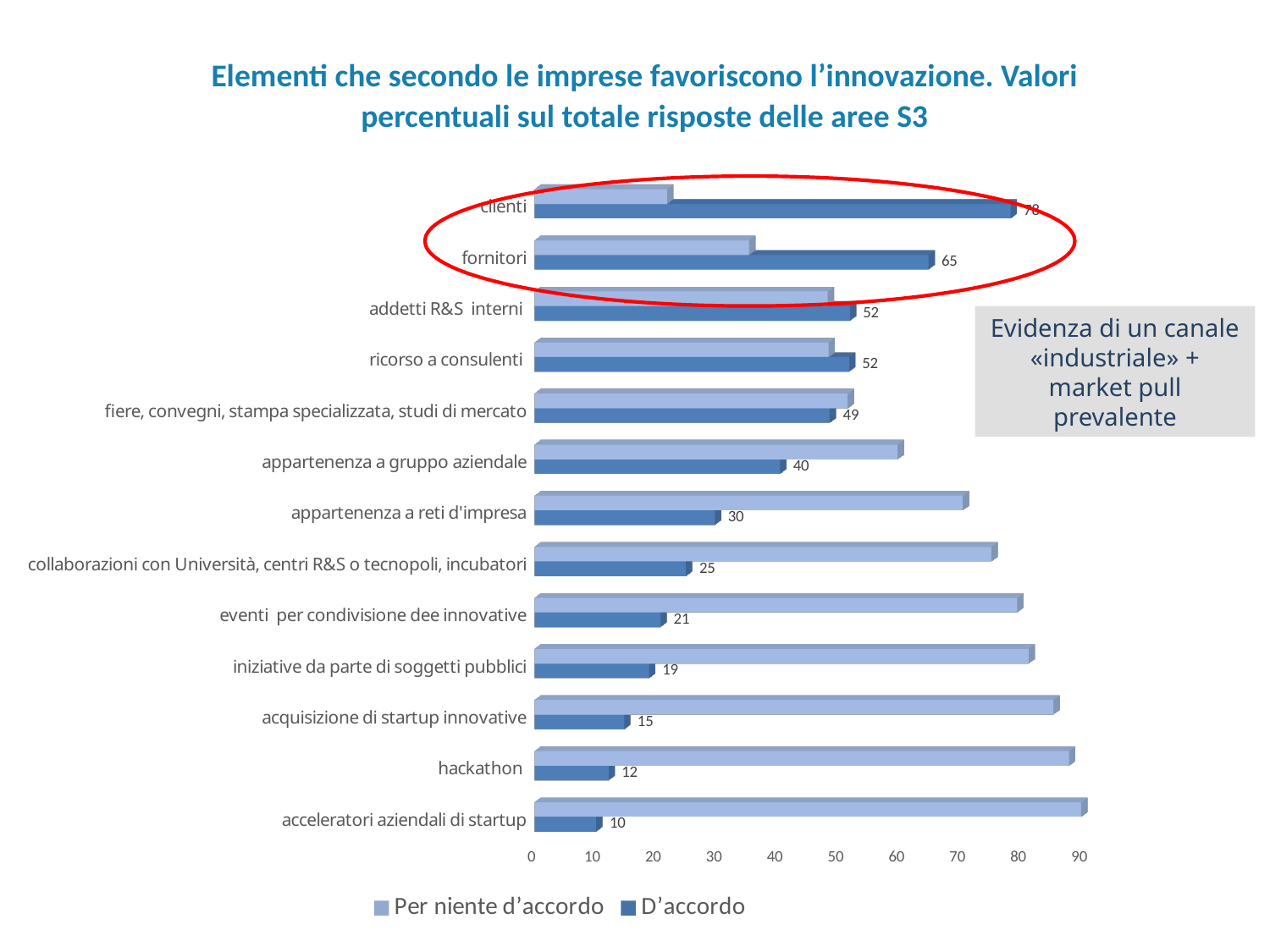
Is the 'Per niente d'accordo' value for hackathon greater or less than 80? greater Which category has the lowest 'D'accordo' value? acceleratori aziendali di startup What is the 'D'accordo' value for hackathon? 12 Which has a larger 'D'accordo' value: appartenenza a gruppo aziendale or appartenenza a reti d'impresa? appartenenza a gruppo aziendale What kind of chart is shown on the slide? bar chart Which category has the highest 'D'accordo' value? clienti What is the 'D'accordo' value for clienti? 78 How many series does the legend list? 2 How many categories are shown in the chart? 13 What is the 'D'accordo' value for fornitori? 65 Is the 'Per niente d'accordo' value for clienti greater or less than 30? less What is the difference between the 'D'accordo' values for clienti and fornitori? 13